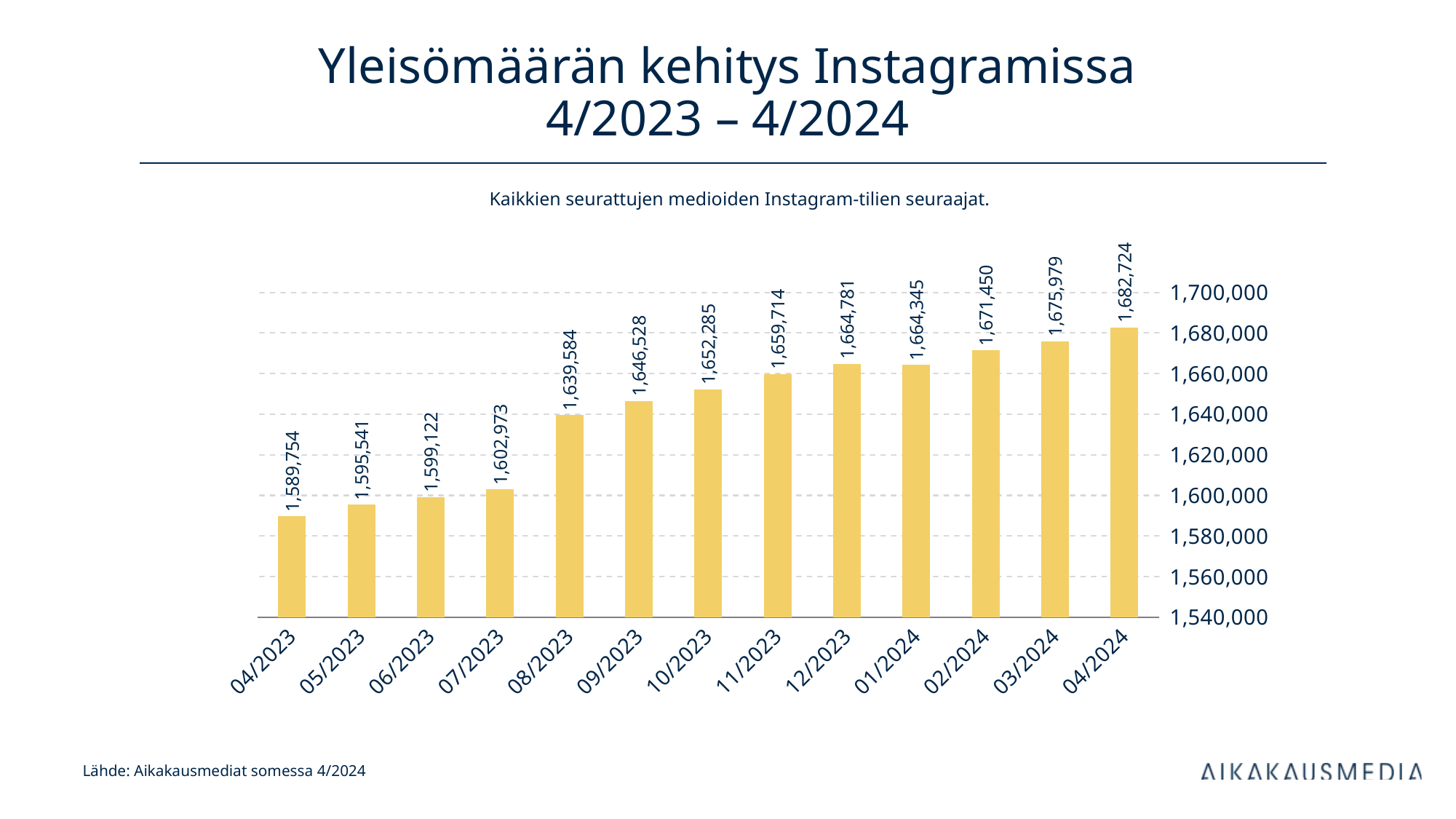
What is the difference between the values for 04/2024 and 04/2023? 92,970 Is the value for 07/2023 greater or less than 1,620,000? less Which month has the highest value? 04/2024 What is the value for 04/2023? 1,589,754 What is the difference between the values for 08/2023 and 07/2023? 36,611 Which month has the lowest value? 04/2023 What kind of chart is shown on the slide? bar chart What is the value for 08/2023? 1,639,584 Which is larger, the value for 12/2023 or the value for 01/2024? 12/2023 Do the values generally rise or fall from 04/2023 to 04/2024? rise What is the value for 01/2024? 1,664,345 How many months are shown on the x axis? 13